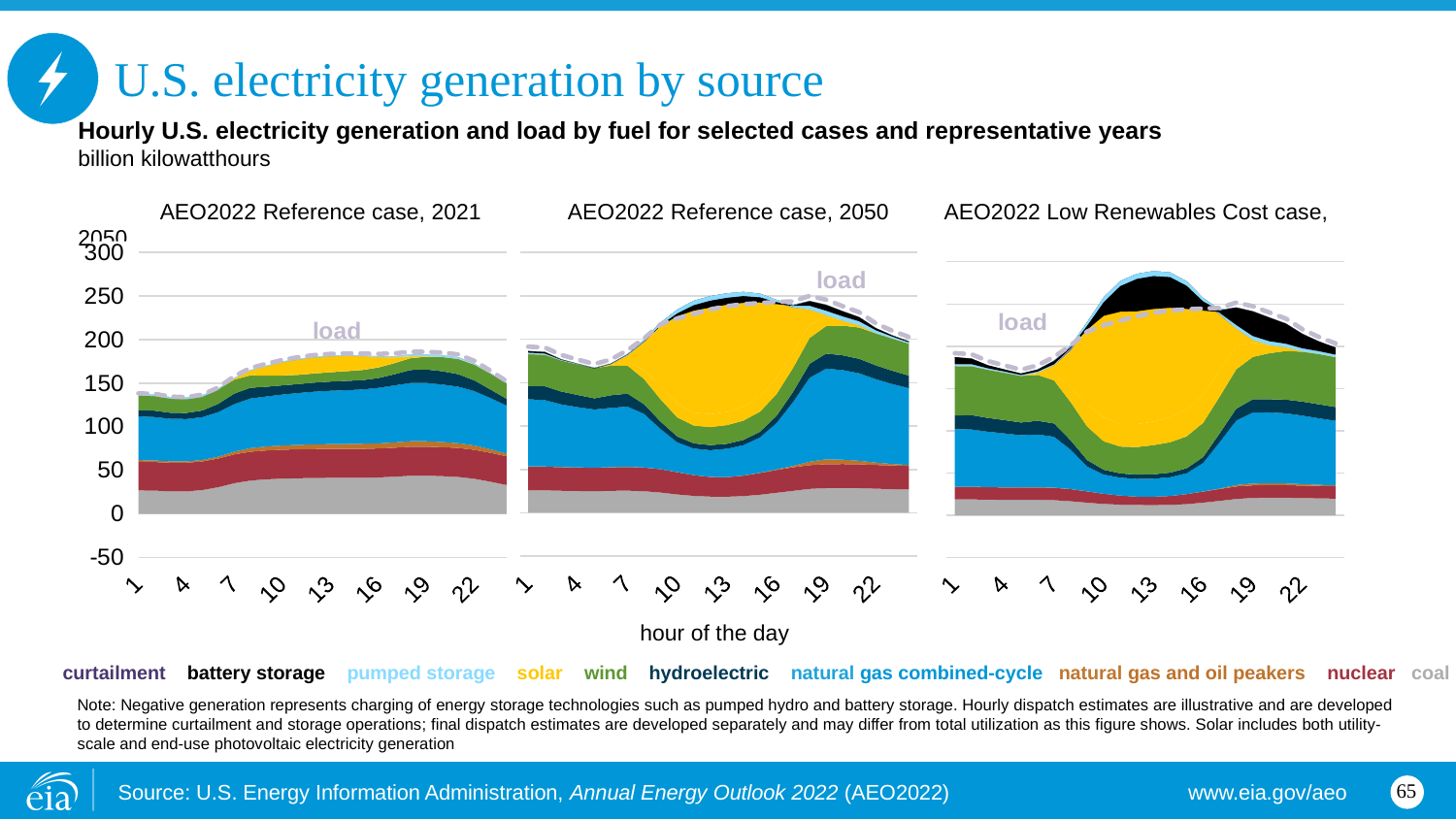
In the AEO2022 Low Renewables Cost case, 2050 chart, is the peak total generation around hour 13 greater or less than 250? greater What kind of chart is used on this slide to show hourly generation by fuel? stacked area chart How many separate charts (cases) are shown on the slide? 3 How many fuel/technology series does the legend list? 10 In the AEO2022 Reference case, 2021 chart, is the load at hour 1 greater or less than 200? less What is the label of the x axis shared by the three charts? hour of the day Which chart shows the higher peak load: AEO2022 Reference case, 2021 or AEO2022 Reference case, 2050? AEO2022 Reference case, 2050 What unit is used for the y axis of the charts? billion kilowatthours In the AEO2022 Reference case, 2050 chart, is the peak load around hour 13 greater or less than 200? greater In the AEO2022 Reference case, 2021 chart, does the load rise or fall from hour 1 to hour 13? rise Which of the three charts shows the highest peak total generation? AEO2022 Low Renewables Cost case, 2050